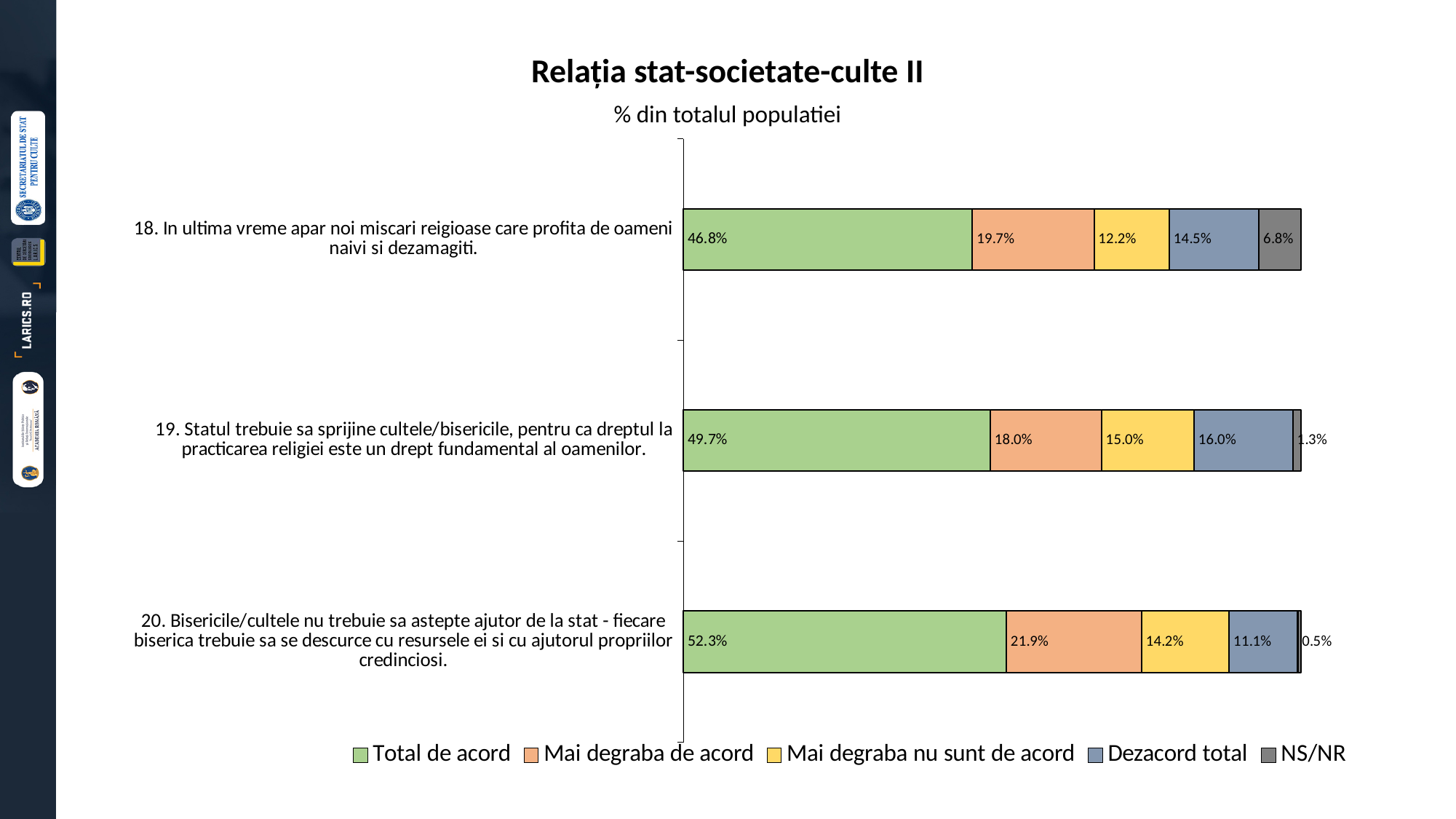
How many series does the legend list? 5 What is the value for "Total de acord" for statement 18 (In ultima vreme apar noi miscari reigioase care profita de oameni naivi si dezamagiti)? 46.8% Which statement has the highest value for "Total de acord"? 20. Bisericile/cultele nu trebuie sa astepte ajutor de la stat - fiecare biserica trebuie sa se descurce cu resursele ei si cu ajutorul propriilor credinciosi. What is the value for "Dezacord total" for statement 19 (Statul trebuie sa sprijine cultele/bisericile...)? 16.0% What is the total of the stacked bar for statement 19? 100.0% What kind of chart is shown on the slide? Stacked bar chart Which statement has the lowest value for "NS/NR"? 20. Bisericile/cultele nu trebuie sa astepte ajutor de la stat - fiecare biserica trebuie sa se descurce cu resursele ei si cu ajutorul propriilor credinciosi. How many statements (categories) are shown in the chart? 3 What is the difference between the "Total de acord" values for statement 20 and statement 18? 5.5 percentage points What is the value for "NS/NR" for statement 20 (Bisericile/cultele nu trebuie sa astepte ajutor de la stat...)? 0.5% Which is larger: the "Mai degraba de acord" value for statement 18 or for statement 19? Statement 18 (19.7%) What is the title of the chart? Relația stat-societate-culte II